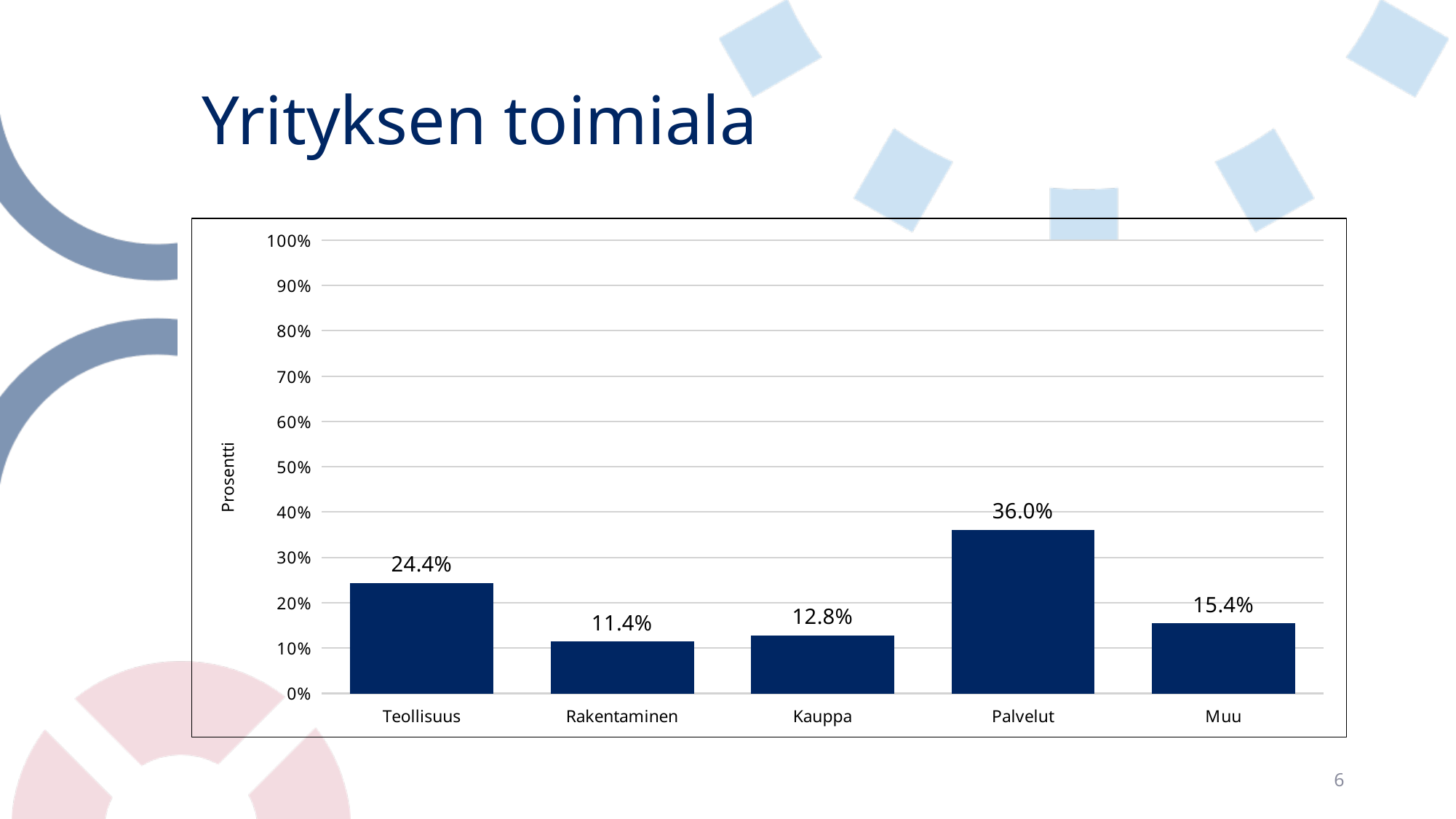
What is the difference between the values for Palvelut and Teollisuus? 11.6% What is the value for Palvelut? 36.0% Is the value for Palvelut greater or less than 30%? greater What kind of chart is shown on the slide? Bar chart Which category has the highest value? Palvelut What is the value for Kauppa? 12.8% Which is larger, the value for Muu or the value for Kauppa? Muu Which category has the lowest value? Rakentaminen How many categories are shown on the x axis? 5 What is the value for Muu? 15.4% What is the value for Rakentaminen? 11.4% What is the value for Teollisuus? 24.4%